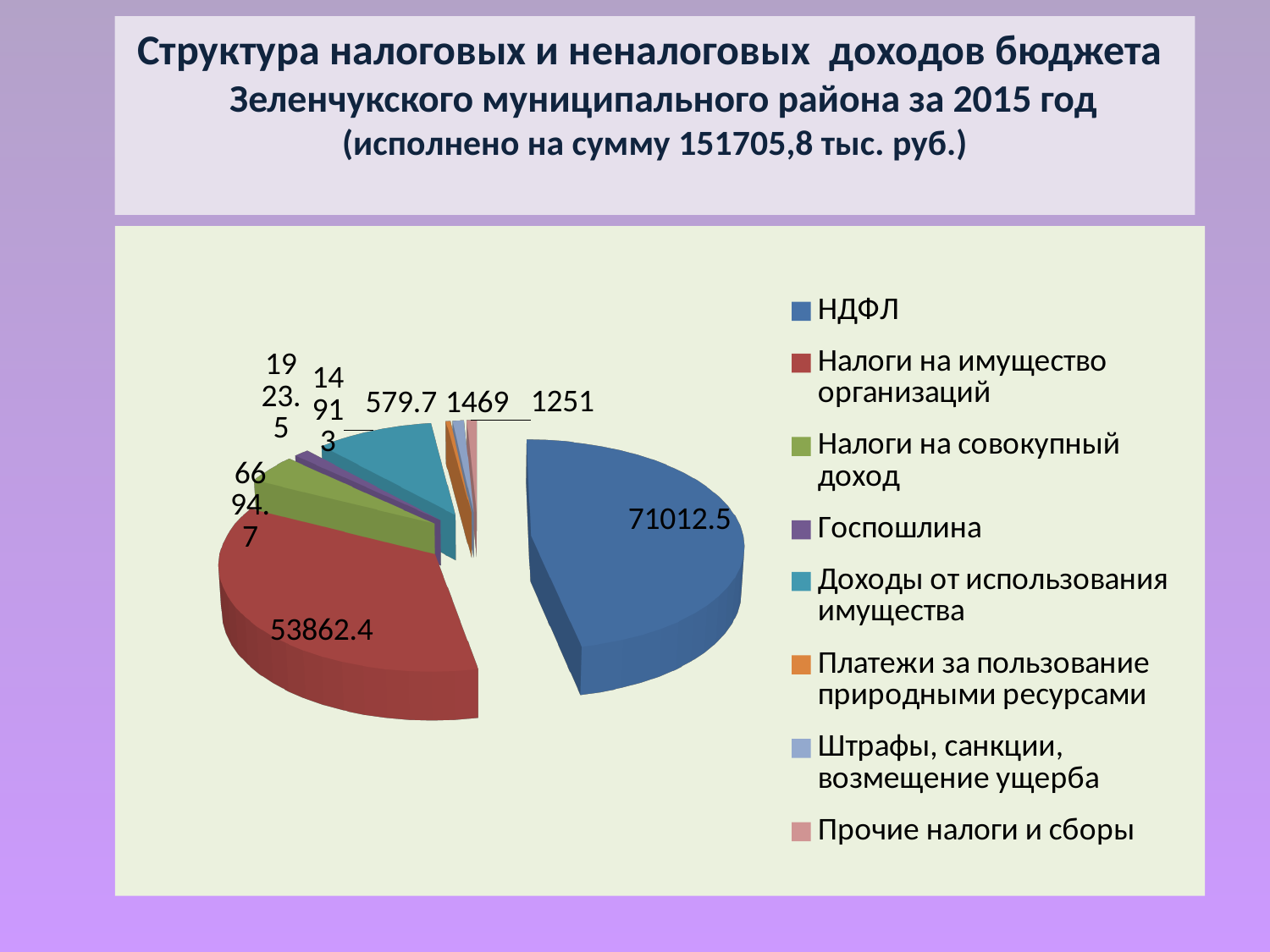
What is the value shown for Прочие налоги и сборы? 1251 Which is larger, НДФЛ or Налоги на имущество организаций? НДФЛ What is the value shown for Штрафы, санкции, возмещение ущерба? 1469 Which category has the largest slice of the pie? НДФЛ What is the value shown for Налоги на имущество организаций? 53862.4 What is the difference between the values for НДФЛ and Налоги на имущество организаций? 17150.1 What kind of chart is shown on the slide? pie chart How many categories does the legend of the pie chart list? 8 Which category has the smallest slice of the pie? Платежи за пользование природными ресурсами What is the value shown for НДФЛ? 71012.5 What is the value shown for Платежи за пользование природными ресурсами? 579.7 What colour is the slice for Доходы от использования имущества? teal